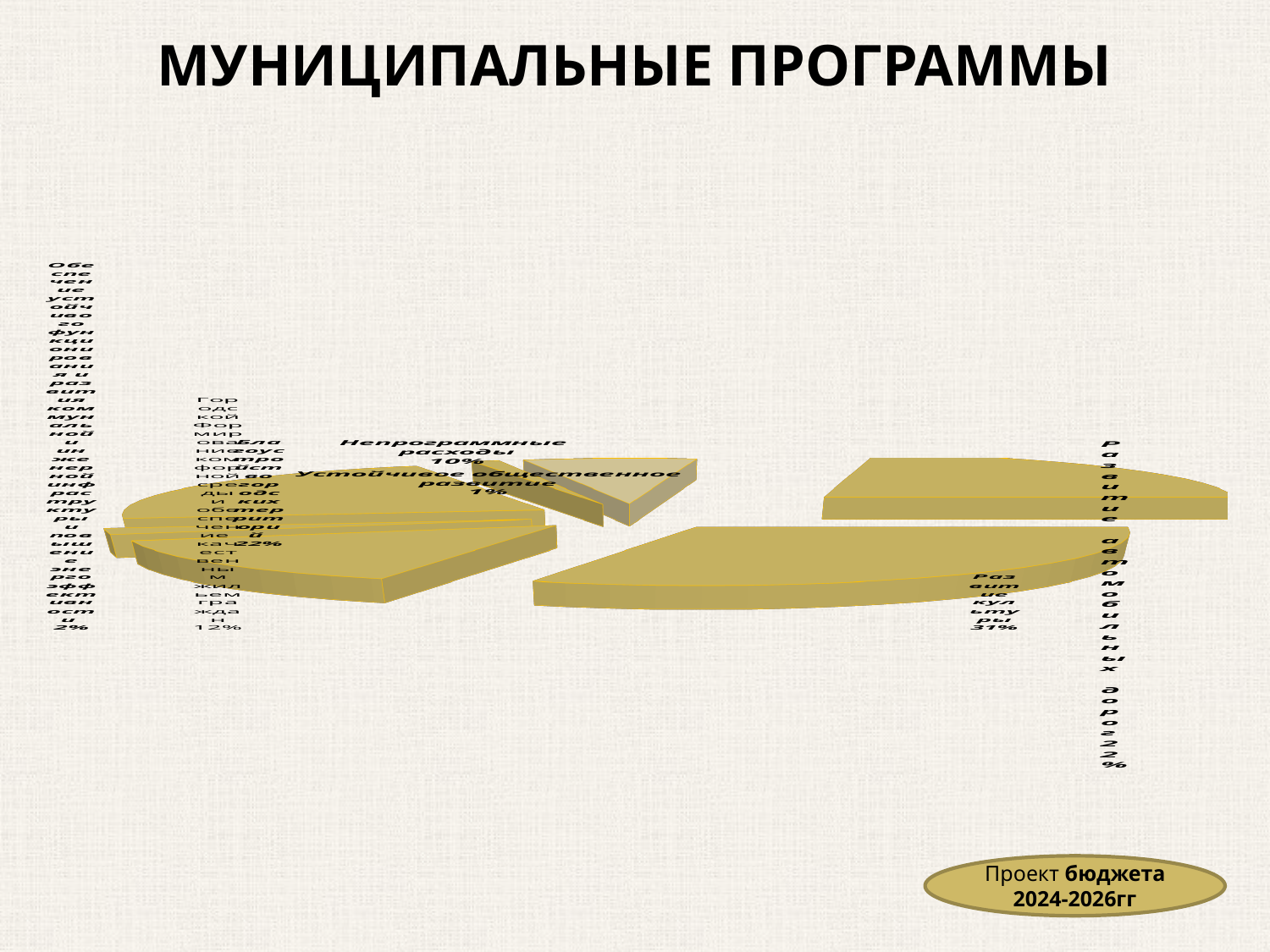
Which is larger: the share for "Непрограммные расходы" or for "Развитие культуры"? Развитие культуры Which labelled slice has the smallest share? Устойчивое общественное развитие By how many percentage points does "Развитие культуры" exceed "Непрограммные расходы"? 21 What text appears in the oval at the bottom right of the slide? Проект бюджета 2024-2026гг What is the title shown at the top of the slide? МУНИЦИПАЛЬНЫЕ ПРОГРАММЫ Which labelled slice has the largest share? Развитие культуры What share does the slice labelled "Непрограммные расходы" have? 10% By how many percentage points does "Развитие автомобильных дорог" exceed "Непрограммные расходы"? 12 What share does the slice labelled "Развитие автомобильных дорог" have? 22% What share does the slice labelled "Развитие культуры" have? 31% What share does the slice labelled "Устойчивое общественное развитие" have? 1% What kind of chart is shown on the slide? pie chart